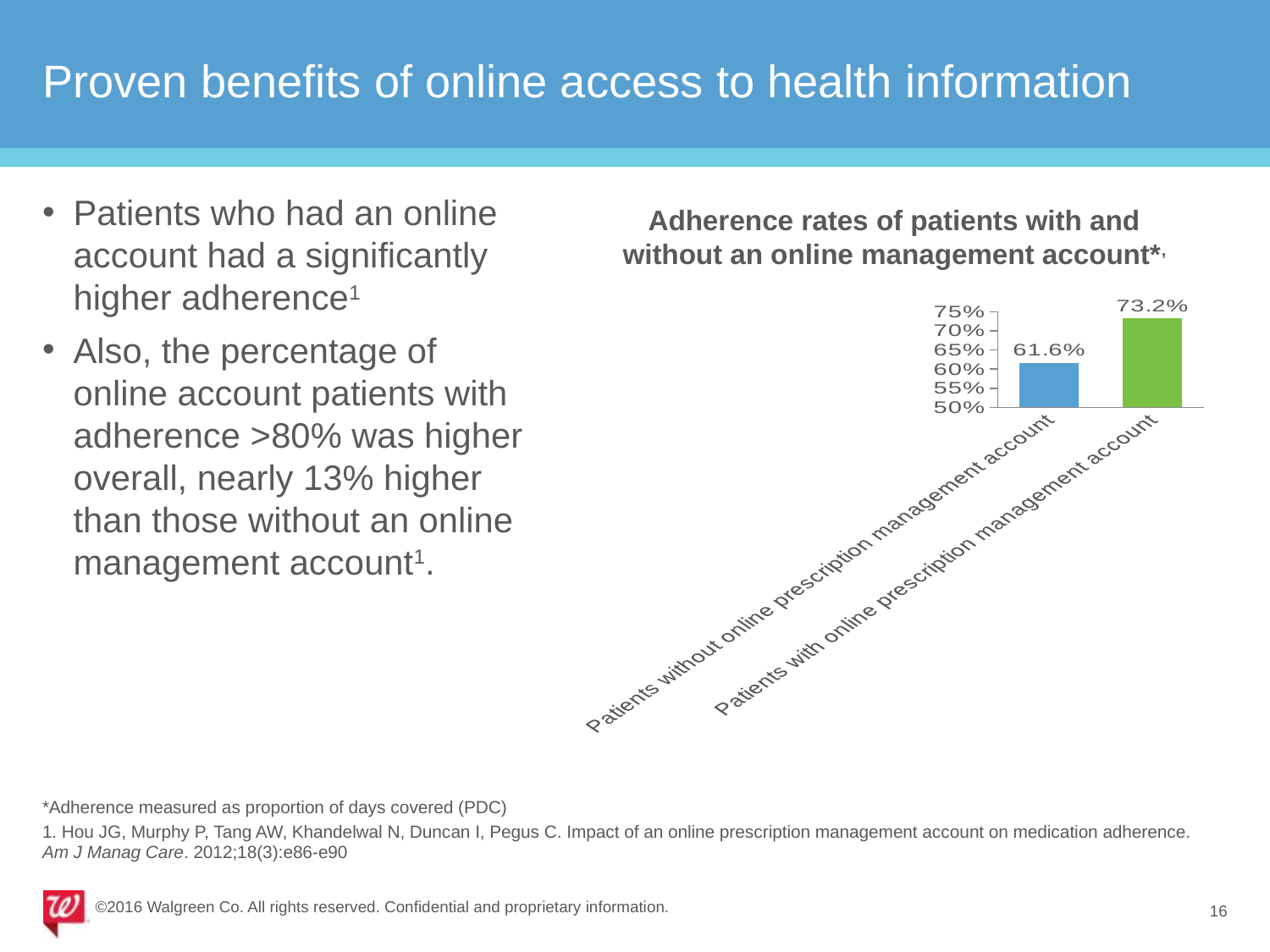
How many categories are shown in the chart? 2 Which is larger: the adherence rate for patients with an online account or for patients without one? Patients with online prescription management account Which category has the lowest adherence rate? Patients without online prescription management account What is the adherence rate for patients without an online prescription management account? 61.6% Is the adherence rate for patients with an online prescription management account greater or less than 70%? greater What kind of chart is shown on the slide? Bar chart What colour is the bar for patients with an online prescription management account? Green Is the adherence rate for patients without an online prescription management account greater or less than 65%? less Which category has the highest adherence rate? Patients with online prescription management account What is the difference in adherence rate between patients with and without an online prescription management account? 11.6% What is the adherence rate for patients with an online prescription management account? 73.2% What is the title of the chart? Adherence rates of patients with and without an online management account*